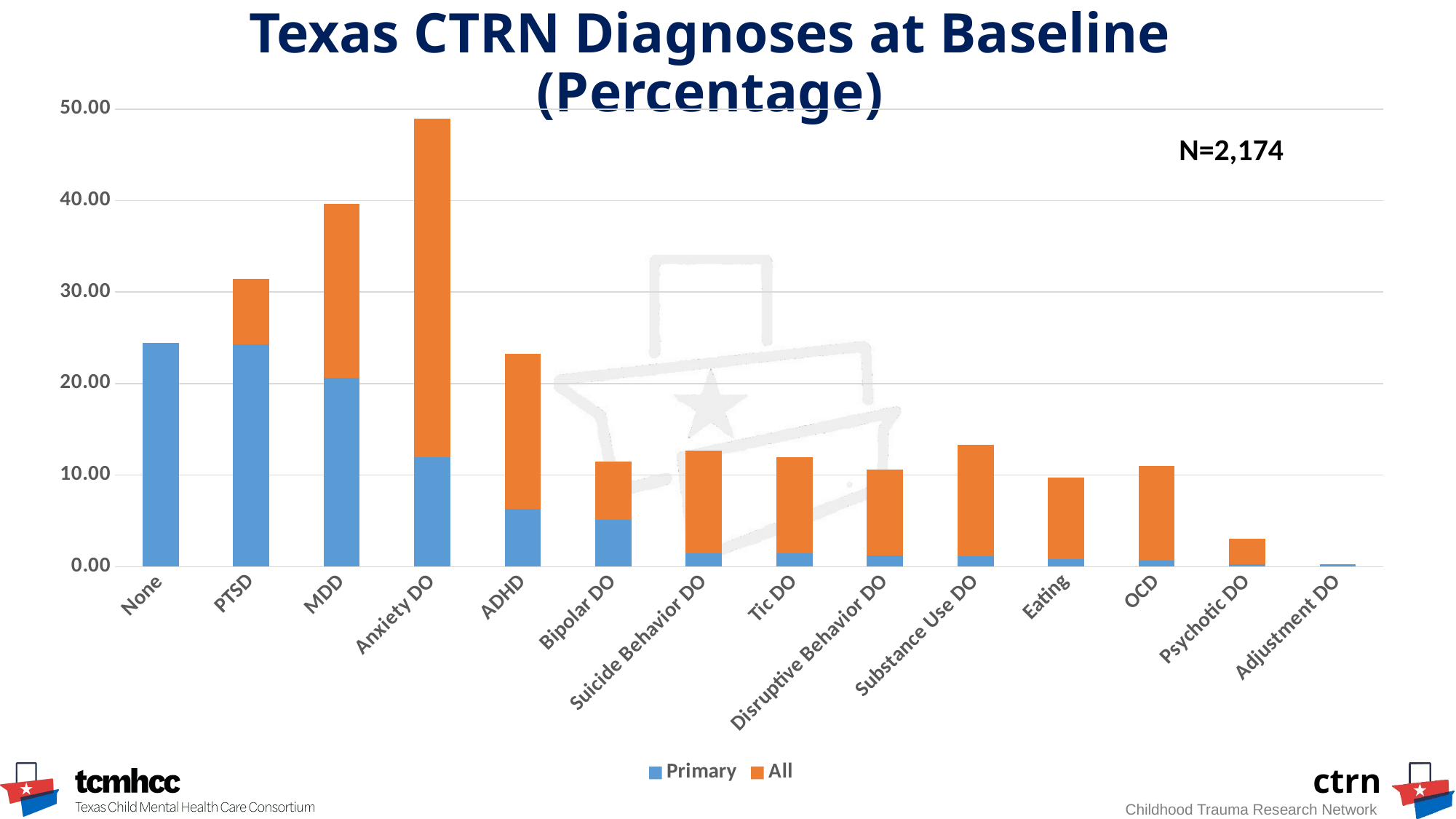
Which diagnosis category has the tallest stacked bar overall? Anxiety DO What sample size (N) is stated on the slide? N=2,174 Is the Primary value for ADHD greater or less than 10.00? less What kind of chart is shown on the slide? Stacked bar chart Which has the larger total stacked bar, Substance Use DO or Eating? Substance Use DO Is the total stacked value for Anxiety DO greater or less than 40.00? greater How many diagnosis categories are shown on the x axis? 14 Which has the larger total stacked bar, MDD or Anxiety DO? Anxiety DO Which diagnosis category has the shortest stacked bar overall? Adjustment DO How many series does the legend list? 2 Is the total stacked value for Psychotic DO greater or less than 10.00? less